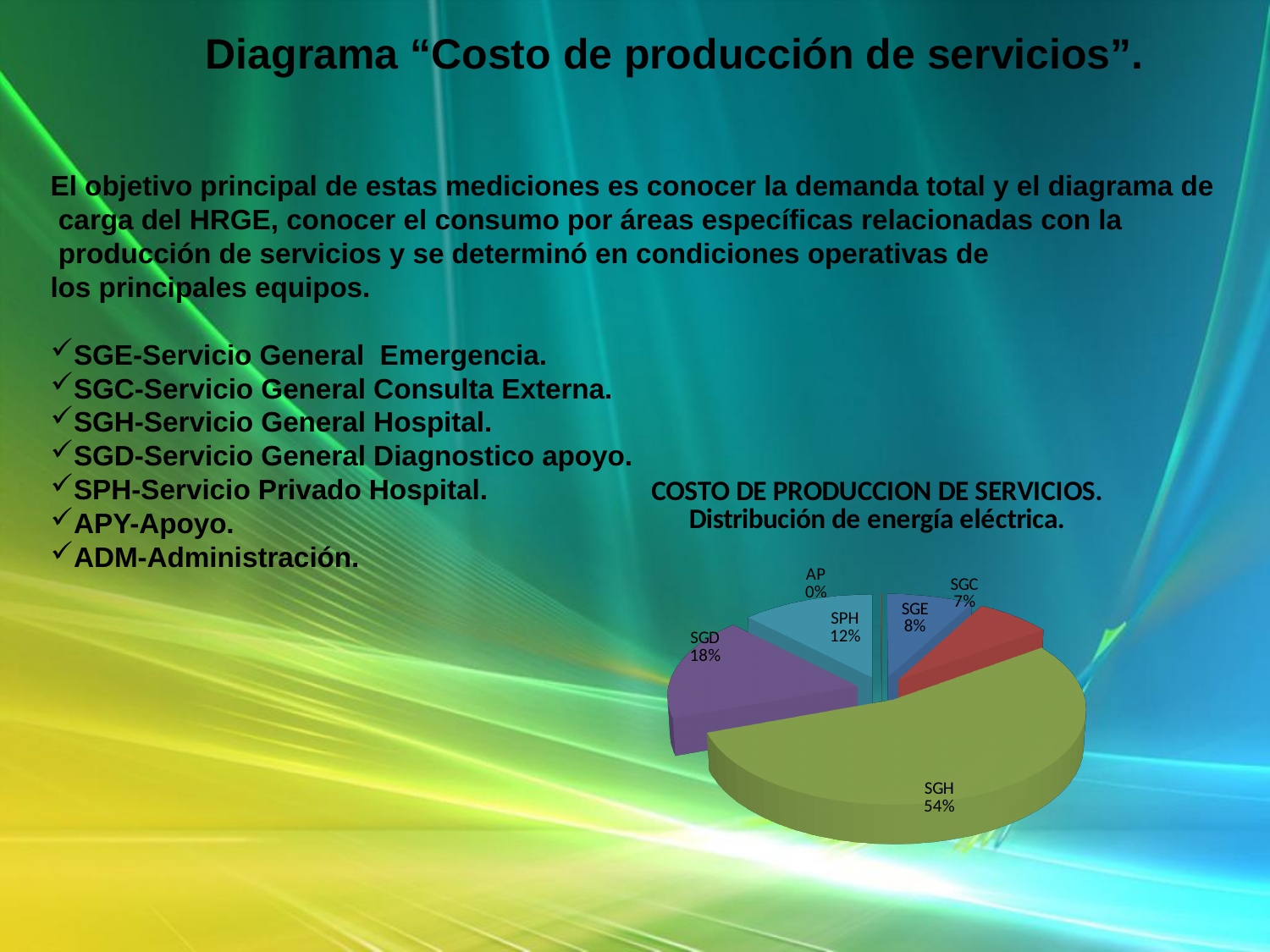
How many slices are labelled in the pie chart? 6 What share of the pie does SGH represent? 54% What share of the pie does SGC represent? 7% What share of the pie does SGD represent? 18% What kind of chart is shown on the slide? pie chart What is the difference in percentage points between the SGH and SGD slices? 36 What is the title of the pie chart? COSTO DE PRODUCCION DE SERVICIOS. Distribución de energía eléctrica. Which category has the smallest slice of the pie? AP Which category has the largest slice of the pie? SGH